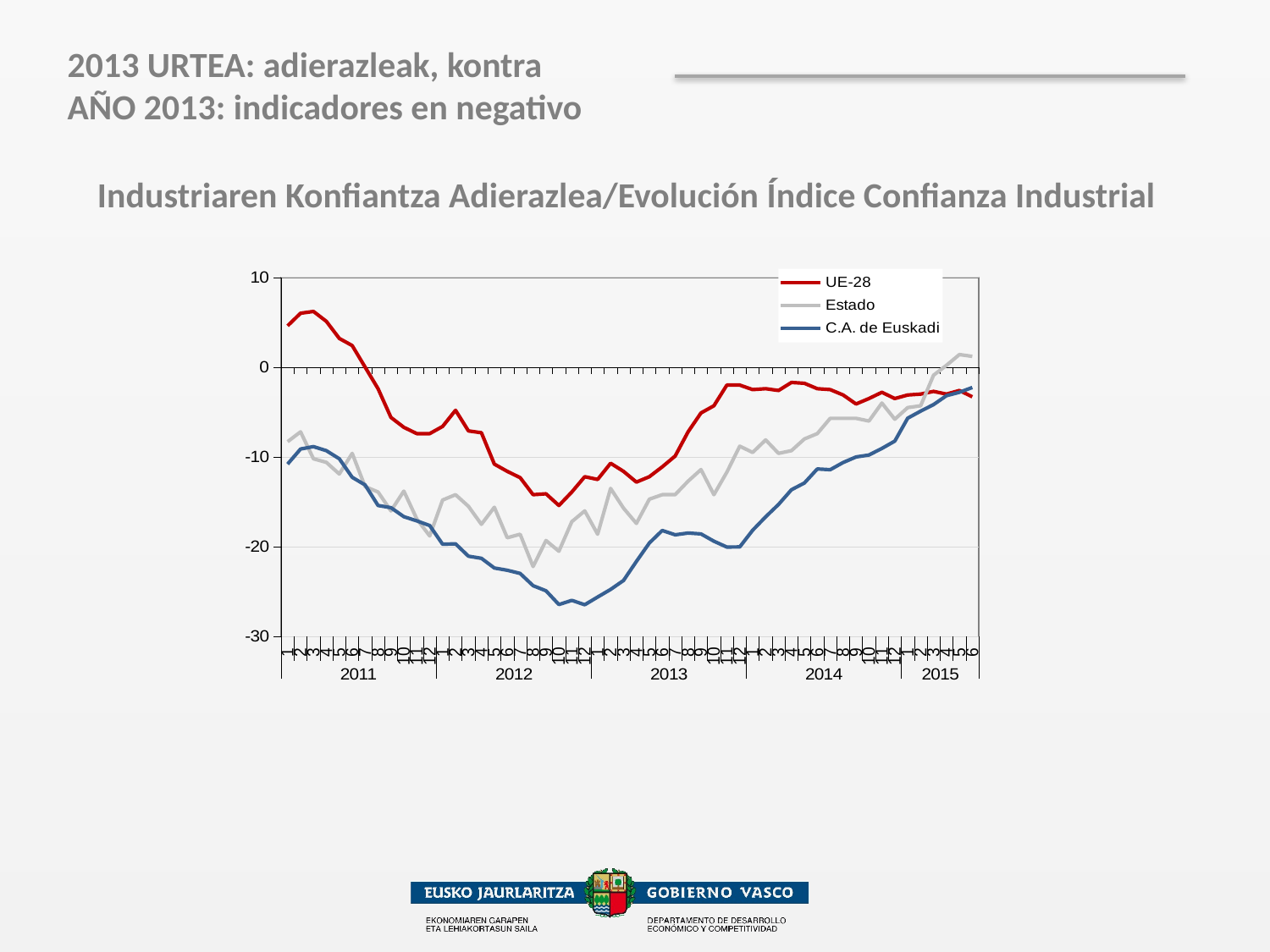
Which series reaches the lowest value anywhere on the chart? C.A. de Euskadi How many series does the legend list? 3 What is the title of the chart? Industriaren Konfiantza Adierazlea/Evolución Índice Confianza Industrial Is the value for UE-28 at the start of 2011 greater or less than 0? greater Does the C.A. de Euskadi series rise or fall from the start of 2013 to the end of 2014? rise In the middle of 2012, which series is higher, UE-28 or C.A. de Euskadi? UE-28 What kind of chart is shown on the slide? line chart Does the UE-28 series rise or fall over the course of 2011? fall Which series has the highest value at the start of 2011? UE-28 What are the three series named in the legend? UE-28, Estado, C.A. de Euskadi Is the value for Estado at the last point in 2015 greater or less than 0? greater Is the lowest value for C.A. de Euskadi greater or less than -20? less